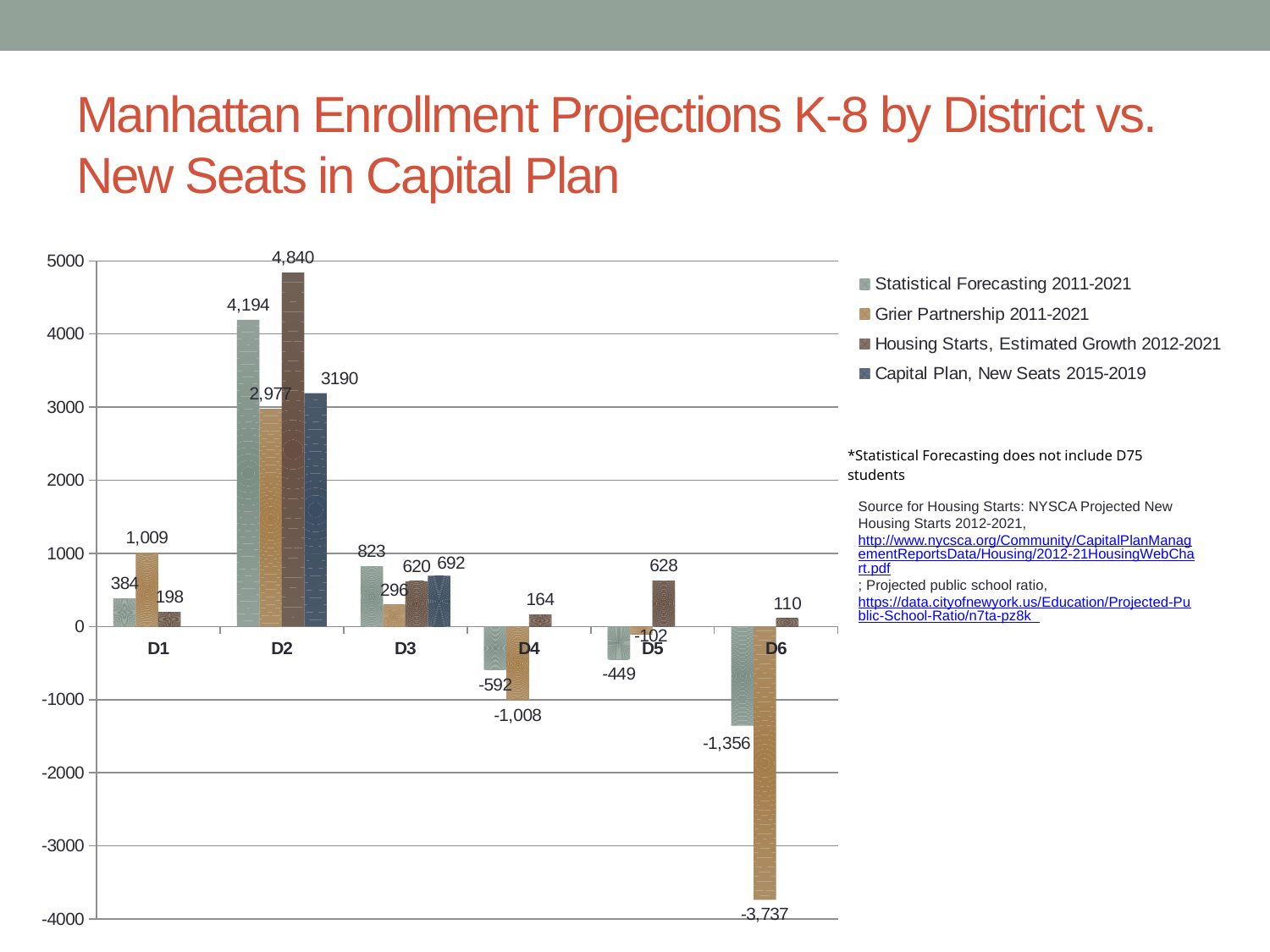
What is the Grier Partnership 2011-2021 value for D6? -3,737 For D3, what is the difference between the Statistical Forecasting value and the Grier Partnership value? 527 Which district has the lowest Grier Partnership 2011-2021 value? D6 How many series does the legend list? 4 What is the Statistical Forecasting 2011-2021 value for D2? 4,194 For D2, what is the difference between the Housing Starts, Estimated Growth value and the Statistical Forecasting value? 646 How many districts are shown on the x axis? 6 What is the Capital Plan, New Seats 2015-2019 value for D3? 692 For D1, which is larger: the Statistical Forecasting 2011-2021 value or the Grier Partnership 2011-2021 value? Grier Partnership 2011-2021 Which district has the highest Housing Starts, Estimated Growth 2012-2021 value? D2 What is the Housing Starts, Estimated Growth 2012-2021 value for D5? 628 What kind of chart is shown on the slide? Bar chart